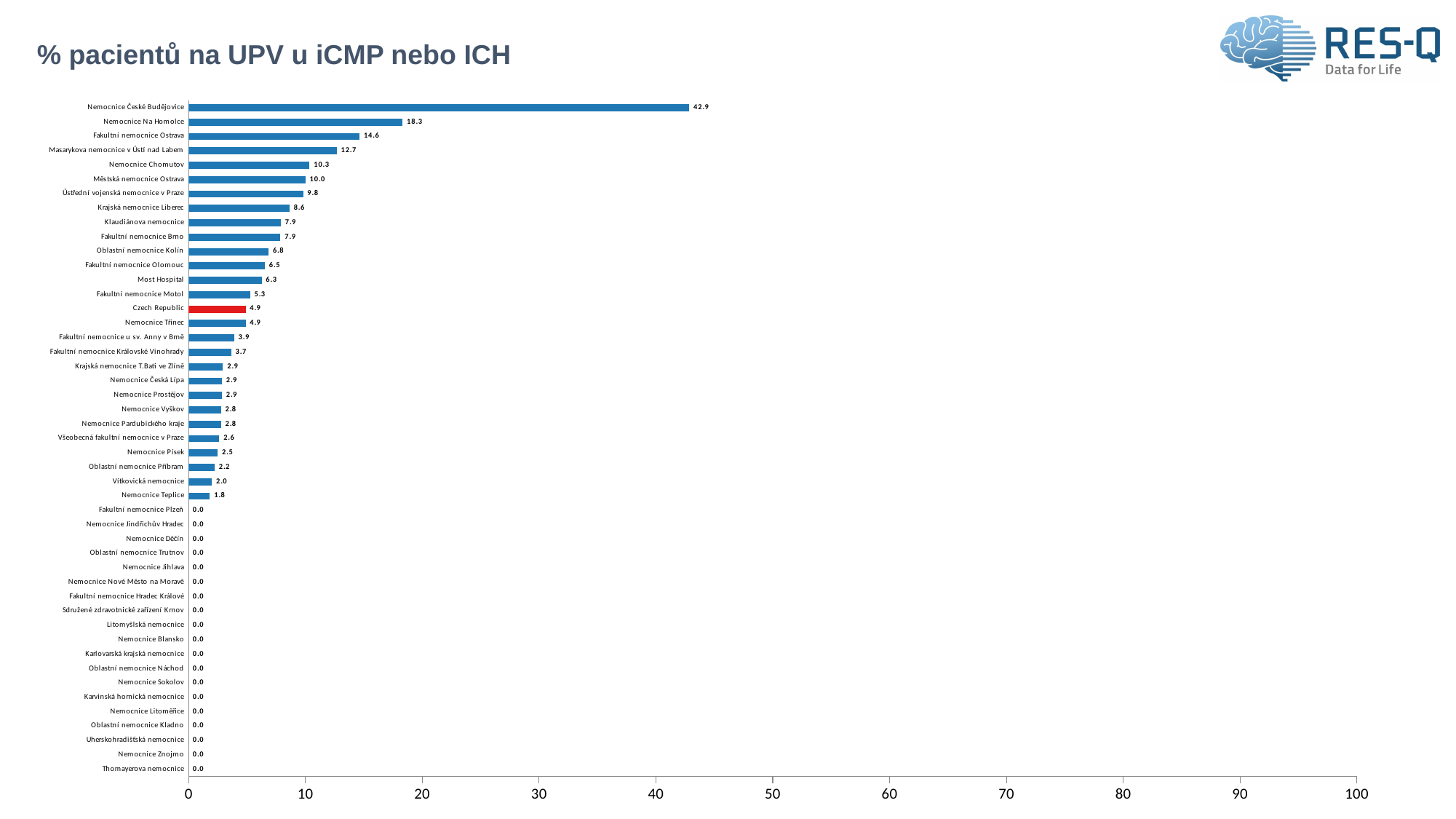
Which hospital has the highest value? Nemocnice České Budějovice What is the value for Fakultní nemocnice Motol? 5.3 How many hospitals have a value of 0.0? 19 What is the title of the chart? % pacientů na UPV u iCMP nebo ICH What kind of chart is shown on the slide? bar chart What is the value for Nemocnice Teplice? 1.8 Is the value for Masarykova nemocnice v Ústí nad Labem greater or less than 10? greater What is the value for Nemocnice České Budějovice? 42.9 Which is larger, the value for Nemocnice Chomutov or Městská nemocnice Ostrava? Nemocnice Chomutov What is the value for Czech Republic? 4.9 What is the difference between Nemocnice Na Homolce and Fakultní nemocnice Ostrava? 3.7 Which bar is coloured red instead of blue? Czech Republic